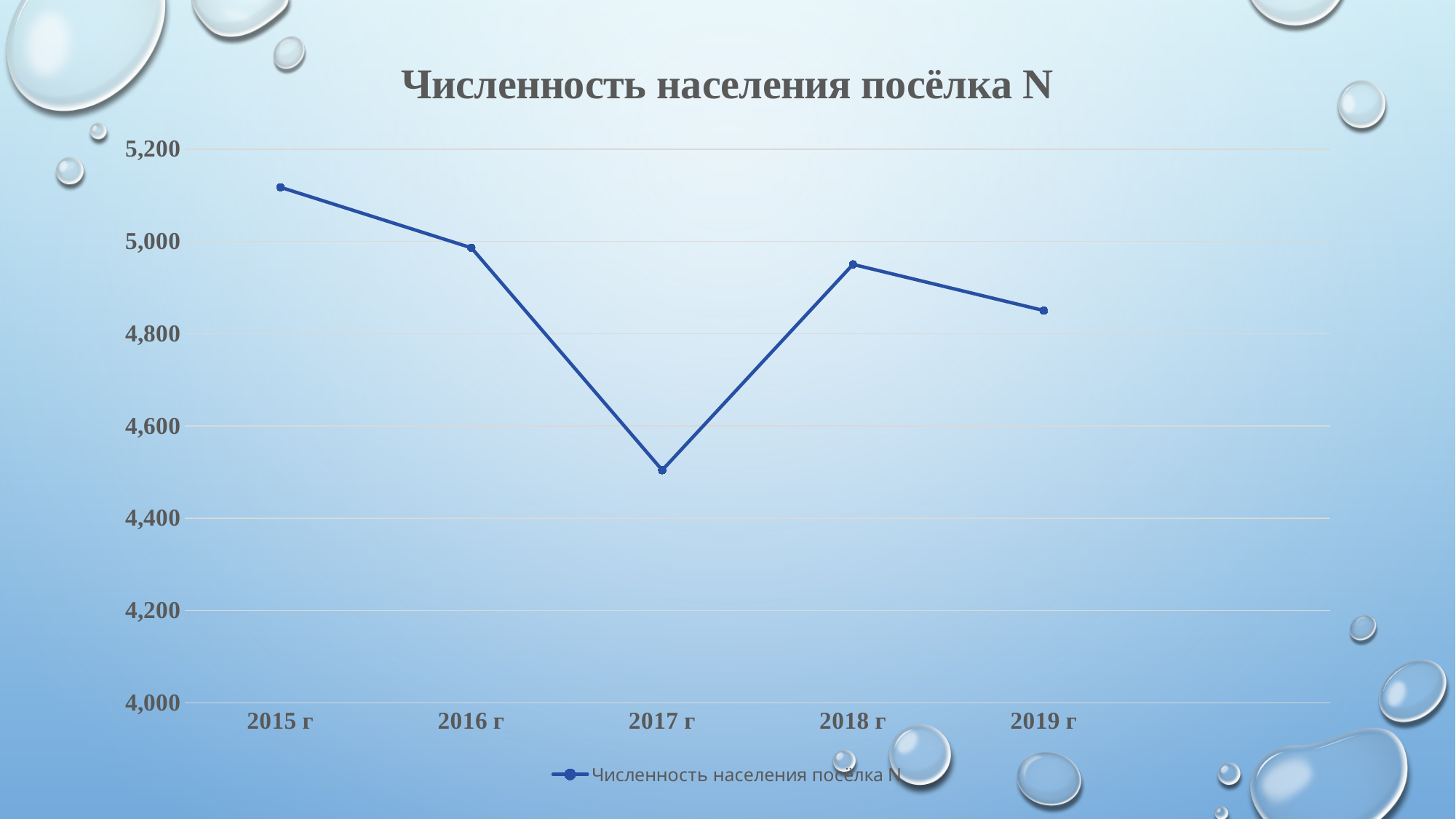
Is the value for 2019 г greater or less than 4,800? greater What is the title of the chart? Численность населения посёлка N In which year is the population highest? 2015 г What type of chart is shown on the slide? line chart In which year is the population lowest? 2017 г How many series does the legend list? 1 How many years are plotted on the x axis? 5 Which year has the larger population, 2015 г or 2019 г? 2015 г Is the value for 2018 г greater or less than 5,000? less Does the population rise or fall from 2015 г to 2017 г? fall Is the value for 2017 г greater or less than 4,600? less